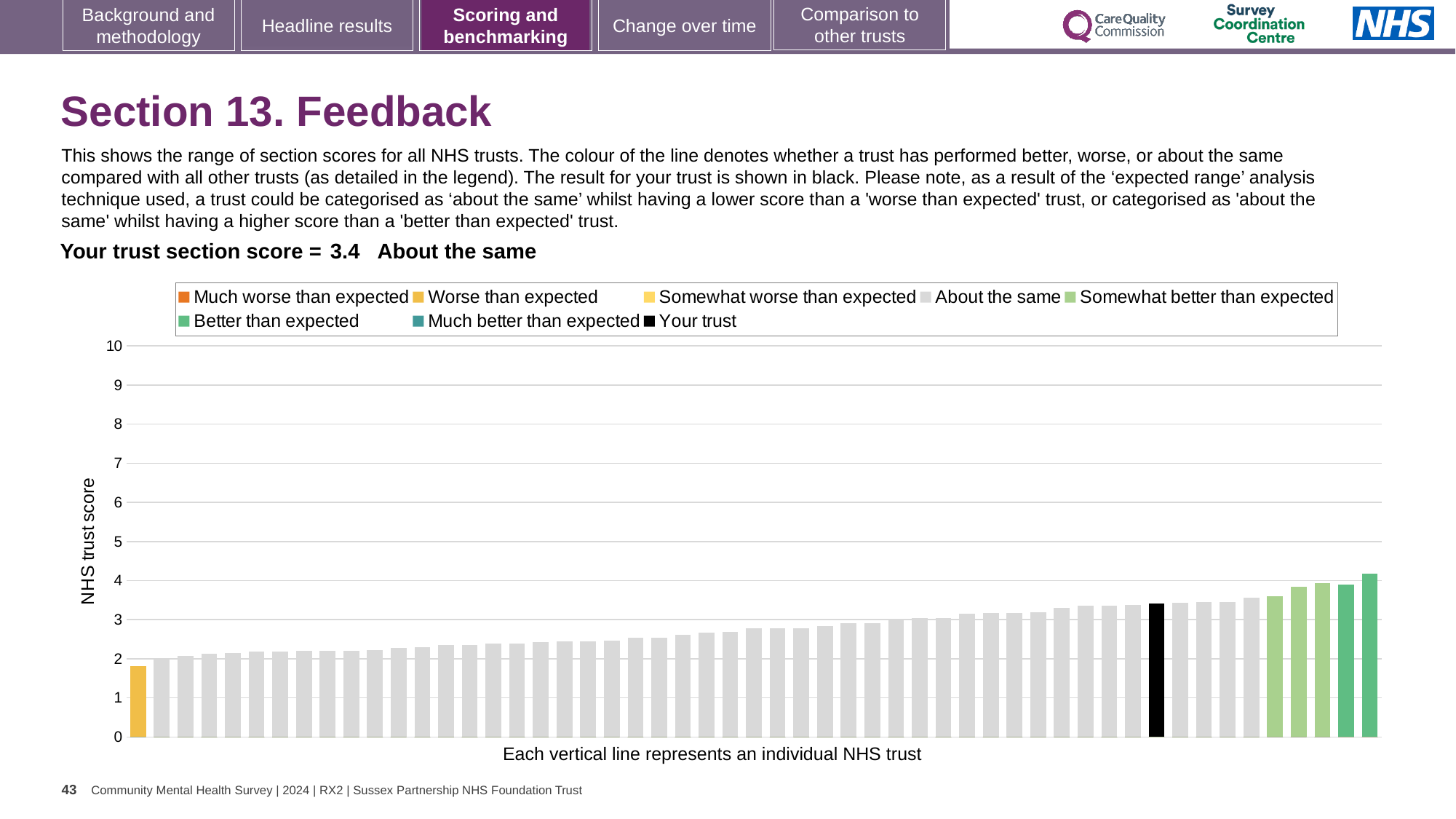
Which legend category does the shortest bar belong to? Worse than expected What is the label on the vertical axis of the chart? NHS trust score How many entries does the chart legend list? 8 Do the bar values rise or fall from left to right along the x axis? Rise Is the value of the shortest bar in the chart greater or less than 2? less Which is larger: the rightmost bar or the black 'Your trust' bar? The rightmost bar What is the section score for your trust shown on the slide? 3.4 Is your trust's score greater or less than 3? greater Which performance category is your trust placed in for Section 13. Feedback? About the same What kind of chart is used to show the range of section scores? Bar chart Which legend category does the tallest bar belong to? Better than expected Is the value of the tallest bar in the chart greater or less than 4? greater